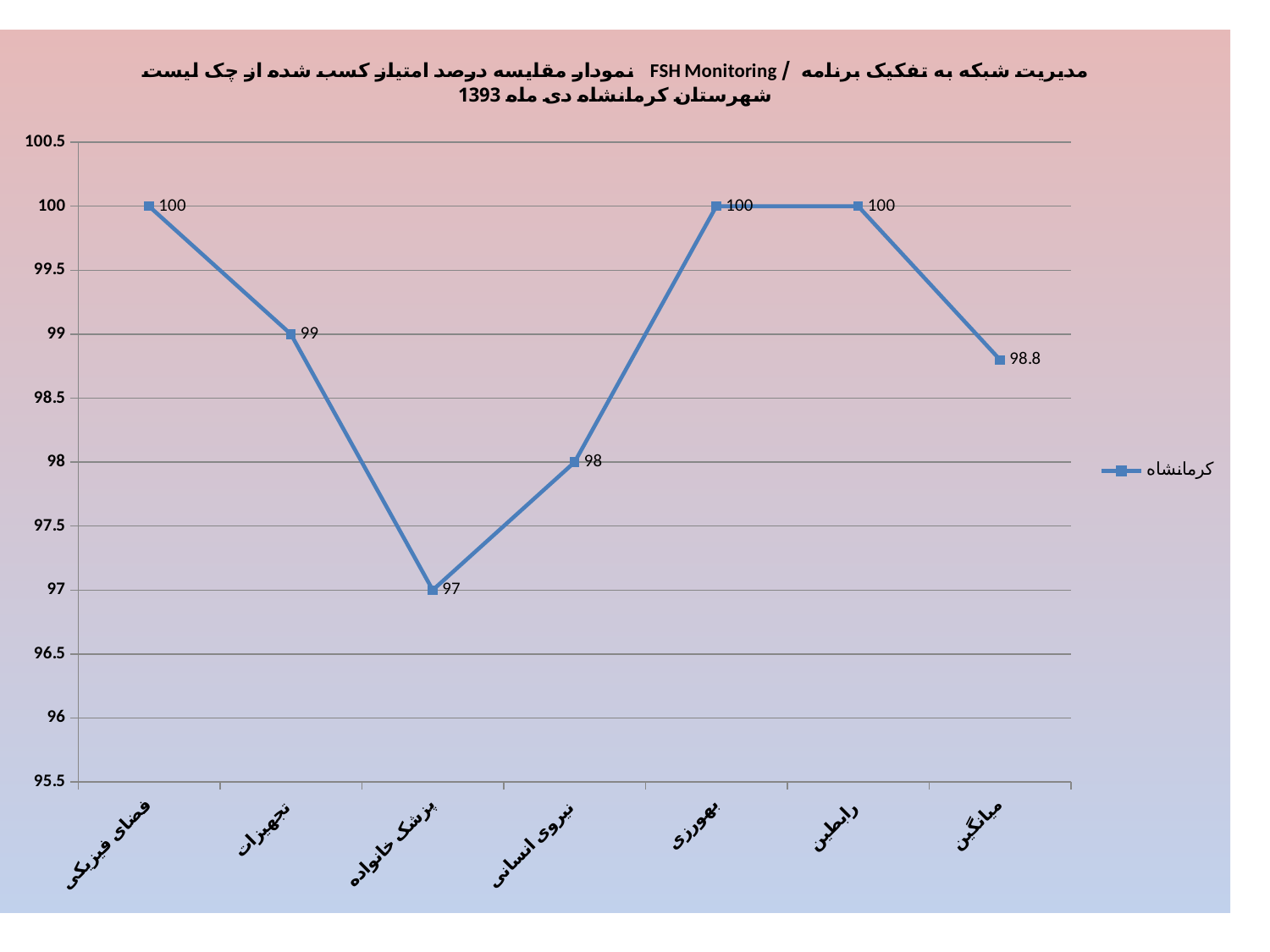
What is the value for پزشک خانواده? 97 Is the value for میانگین greater or less than 99? less Which category has the lowest value? پزشک خانواده What is the value for نیروی انسانی? 98 How many series does the legend list? 1 What is the value for میانگین? 98.8 What is the name of the series shown in the legend? کرمانشاه What is the difference between the values for تجهیزات and پزشک خانواده? 2 How many categories are plotted on the x axis? 7 Which is larger, the value for نیروی انسانی or the value for تجهیزات? تجهیزات What type of chart is shown on the slide? line chart What is the value for تجهیزات? 99